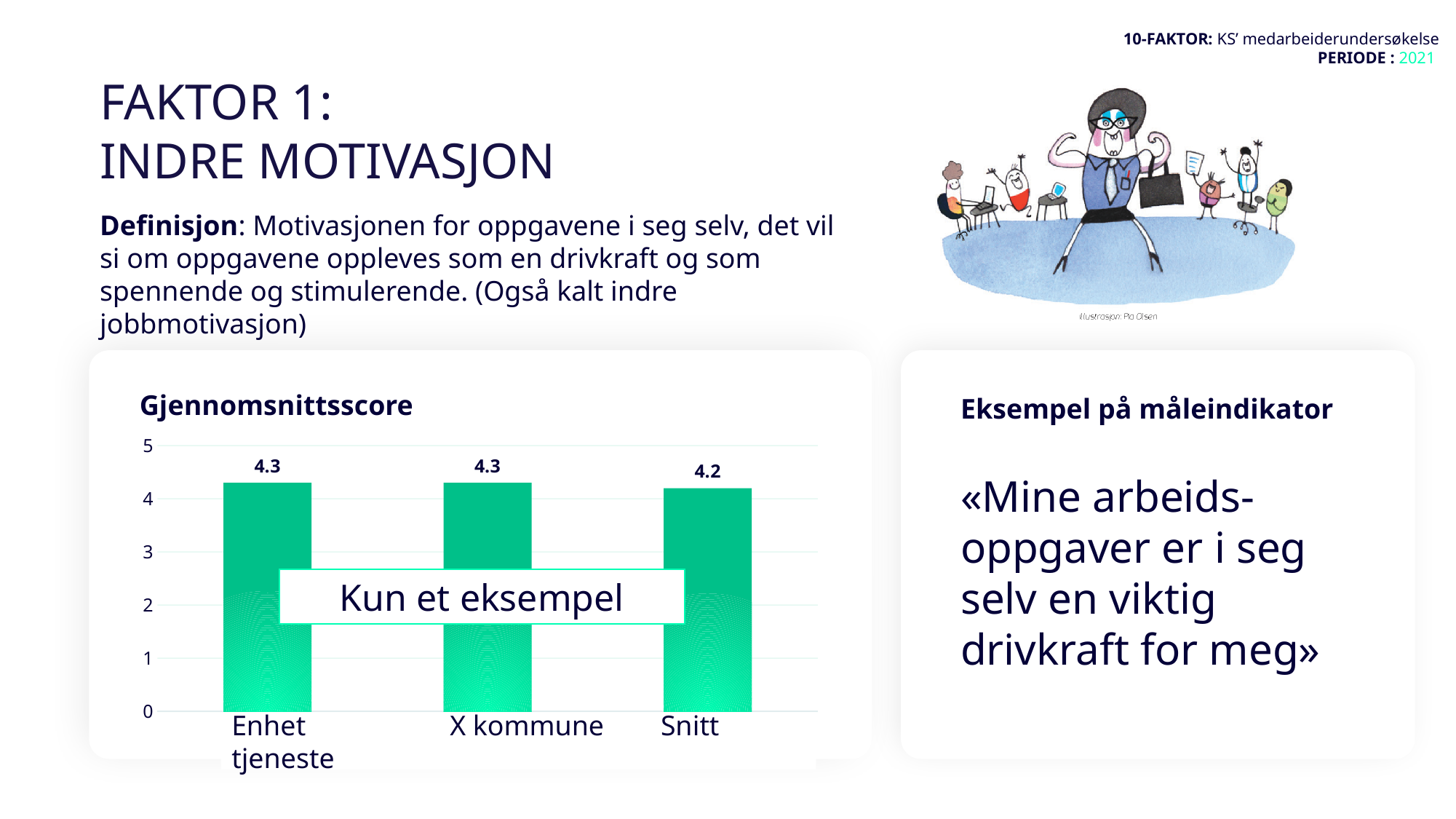
Is the value for Snitt greater or less than 4? greater What is the value for Snitt in the Gjennomsnittsscore chart? 4.2 What is the difference between the values for Enhet tjeneste and Snitt? 0.1 Which category has the lowest value in the Gjennomsnittsscore chart? Snitt What is the value for Enhet tjeneste in the Gjennomsnittsscore chart? 4.3 What is the title of the chart on the slide? Gjennomsnittsscore How many categories are shown in the Gjennomsnittsscore chart? 3 Which is larger, the value for X kommune or the value for Snitt? X kommune What is the value for X kommune in the Gjennomsnittsscore chart? 4.3 What is the maximum value shown on the y axis of the Gjennomsnittsscore chart? 5 Is the value for Enhet tjeneste greater or less than 5? less What kind of chart is the Gjennomsnittsscore chart? bar chart